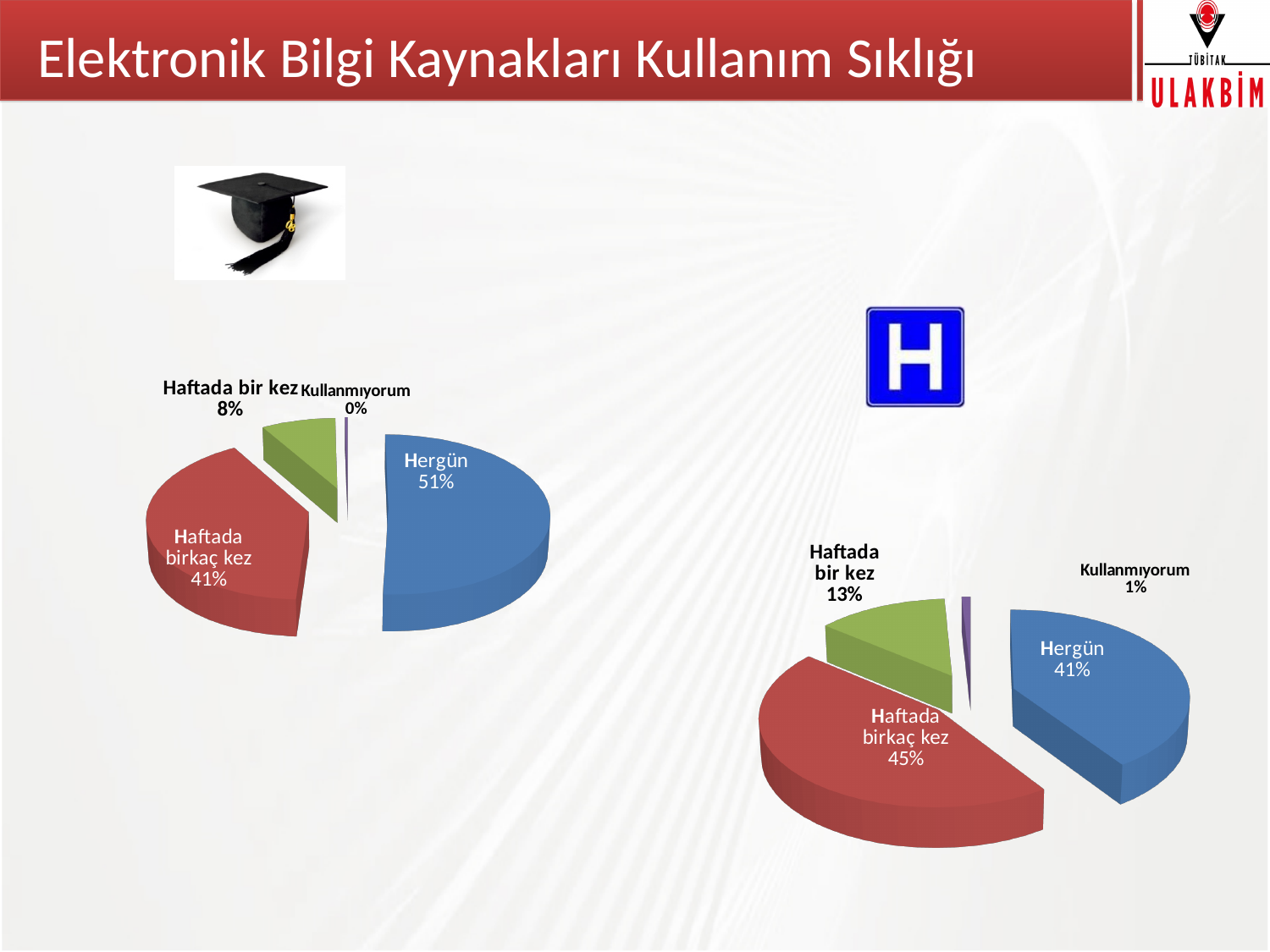
In the pie chart on the right of the slide, what is the value for Haftada bir kez? 13% What type of chart is shown on the right of the slide? Pie chart In the pie chart on the left of the slide, which category has the largest share? Hergün In the pie chart on the right of the slide, which is larger, Hergün or Haftada birkaç kez? Haftada birkaç kez In the pie chart on the left of the slide, what is the value for Hergün? 51% In the pie chart on the right of the slide, what is the value for Hergün? 41% In the pie chart on the right of the slide, which category has the largest share? Haftada birkaç kez In the pie chart on the left of the slide, what is the value for Kullanmıyorum? 0% How many categories does the pie chart on the left of the slide show? 4 In the pie chart on the right of the slide, which category has the smallest share? Kullanmıyorum In the pie chart on the left of the slide, what is the value for Haftada birkaç kez? 41% In the pie chart on the left of the slide, what is the difference between Hergün and Haftada birkaç kez? 10%